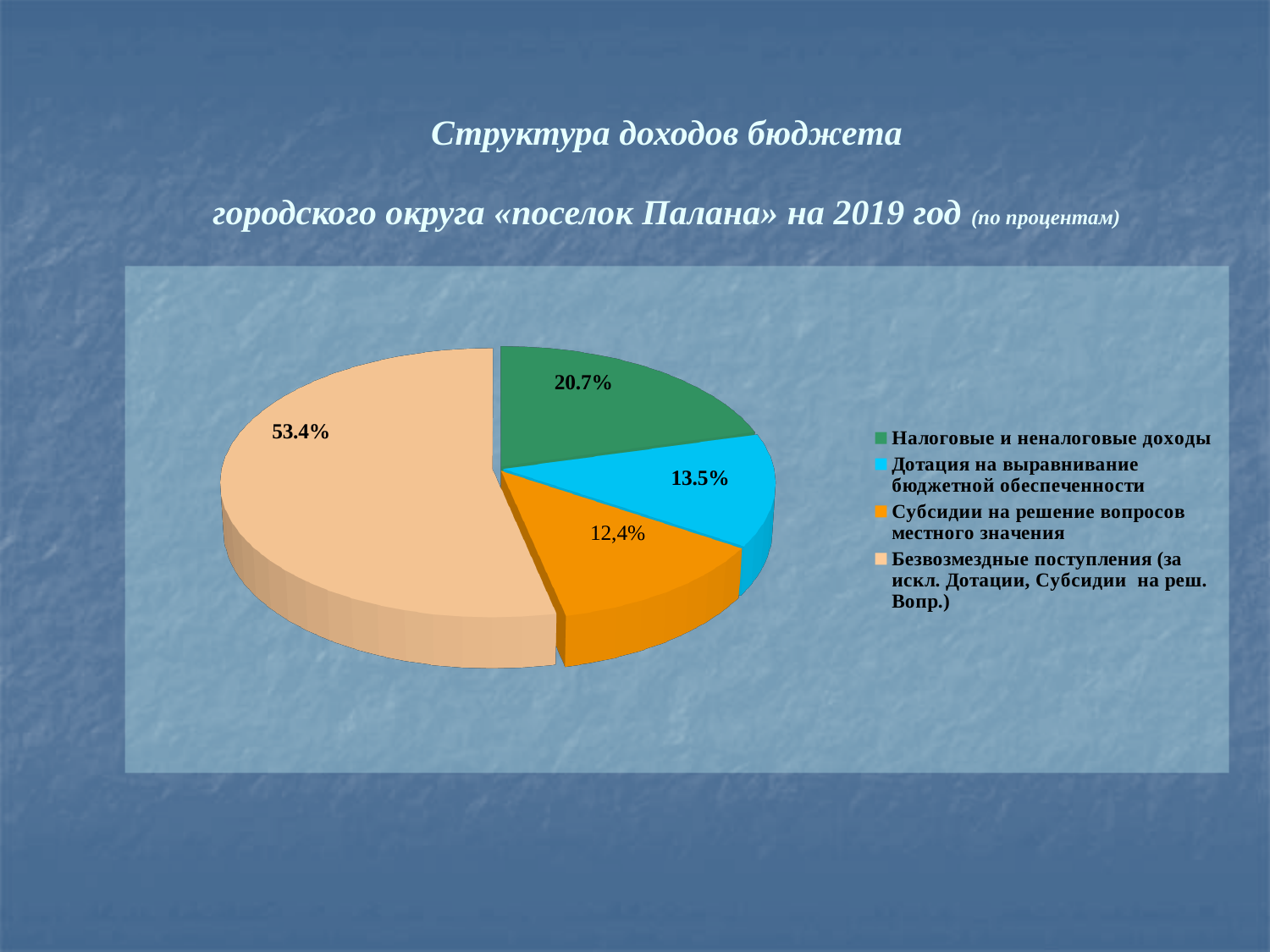
What share of the pie is labelled for «Безвозмездные поступления (за искл. Дотации, Субсидии на реш. Вопр.)»? 53.4% What share of the pie is labelled for «Субсидии на решение вопросов местного значения»? 12,4% Which category has the smallest slice of the pie? Субсидии на решение вопросов местного значения What kind of chart is shown on the slide? Pie chart What is the difference in percentage points between the «Безвозмездные поступления» slice and the «Налоговые и неналоговые доходы» slice? 32.7 What share of the pie is labelled for «Дотация на выравнивание бюджетной обеспеченности»? 13.5% What share of the pie is labelled for «Налоговые и неналоговые доходы»? 20.7% Which is larger: the slice for «Налоговые и неналоговые доходы» or the slice for «Дотация на выравнивание бюджетной обеспеченности»? Налоговые и неналоговые доходы What colour is the slice for «Субсидии на решение вопросов местного значения»? Orange How many slices does the pie chart have? 4 How many entries does the legend list? 4 Which category has the largest slice of the pie? Безвозмездные поступления (за искл. Дотации, Субсидии на реш. Вопр.)